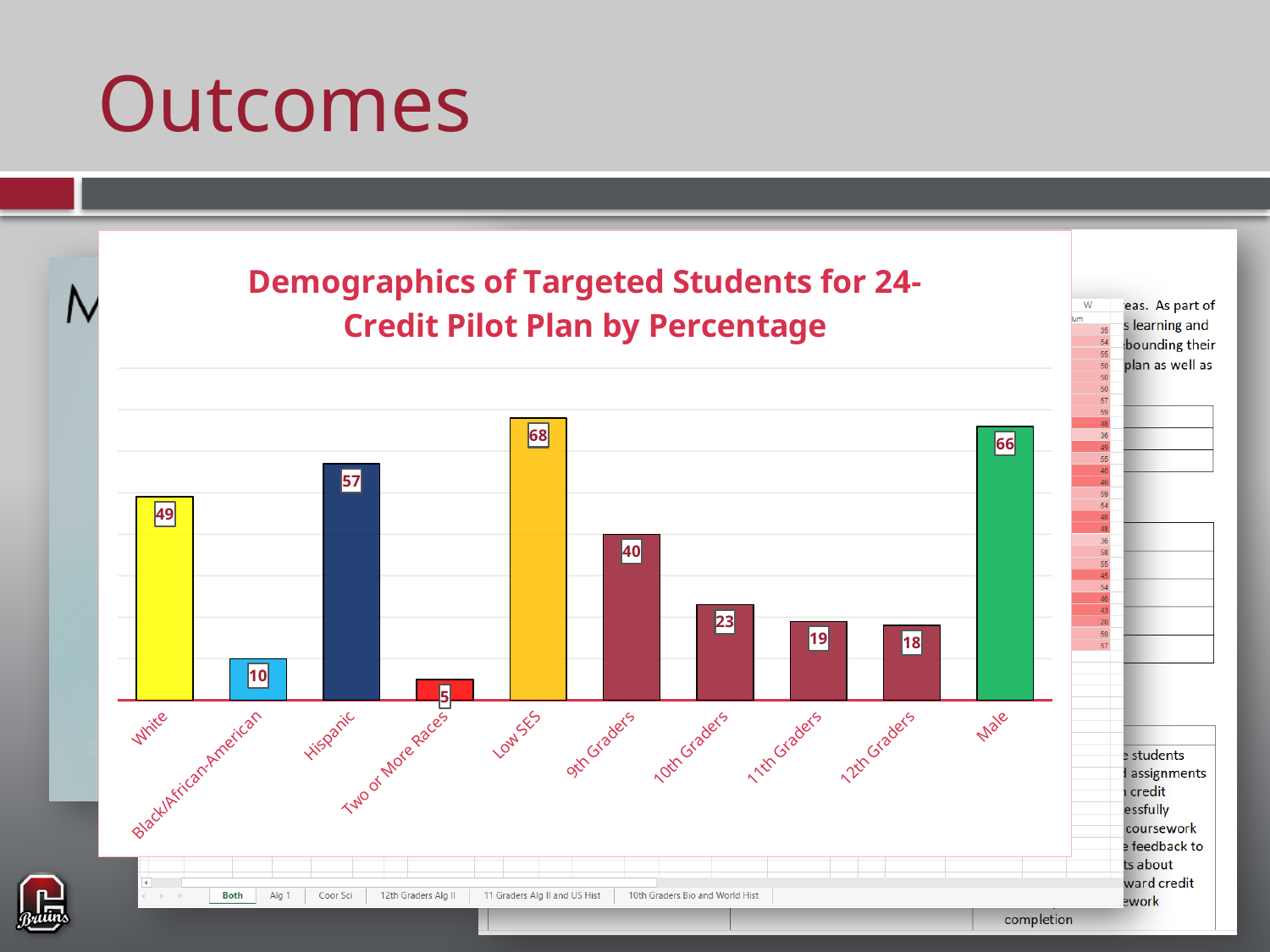
What kind of chart is this? bar chart What is the title of the chart? Demographics of Targeted Students for 24-Credit Pilot Plan by Percentage Which category has the lowest value? Two or More Races What is the value for Male? 66 Which is larger, the value for 10th Graders or the value for 11th Graders? 10th Graders What is the value for Black/African-American? 10 What is the value for Low SES? 68 What is the difference between the values for Hispanic and White? 8 Which category has the highest value? Low SES What is the difference between the values for 9th Graders and 12th Graders? 22 What is the value for 9th Graders? 40 How many categories are shown in the chart? 10